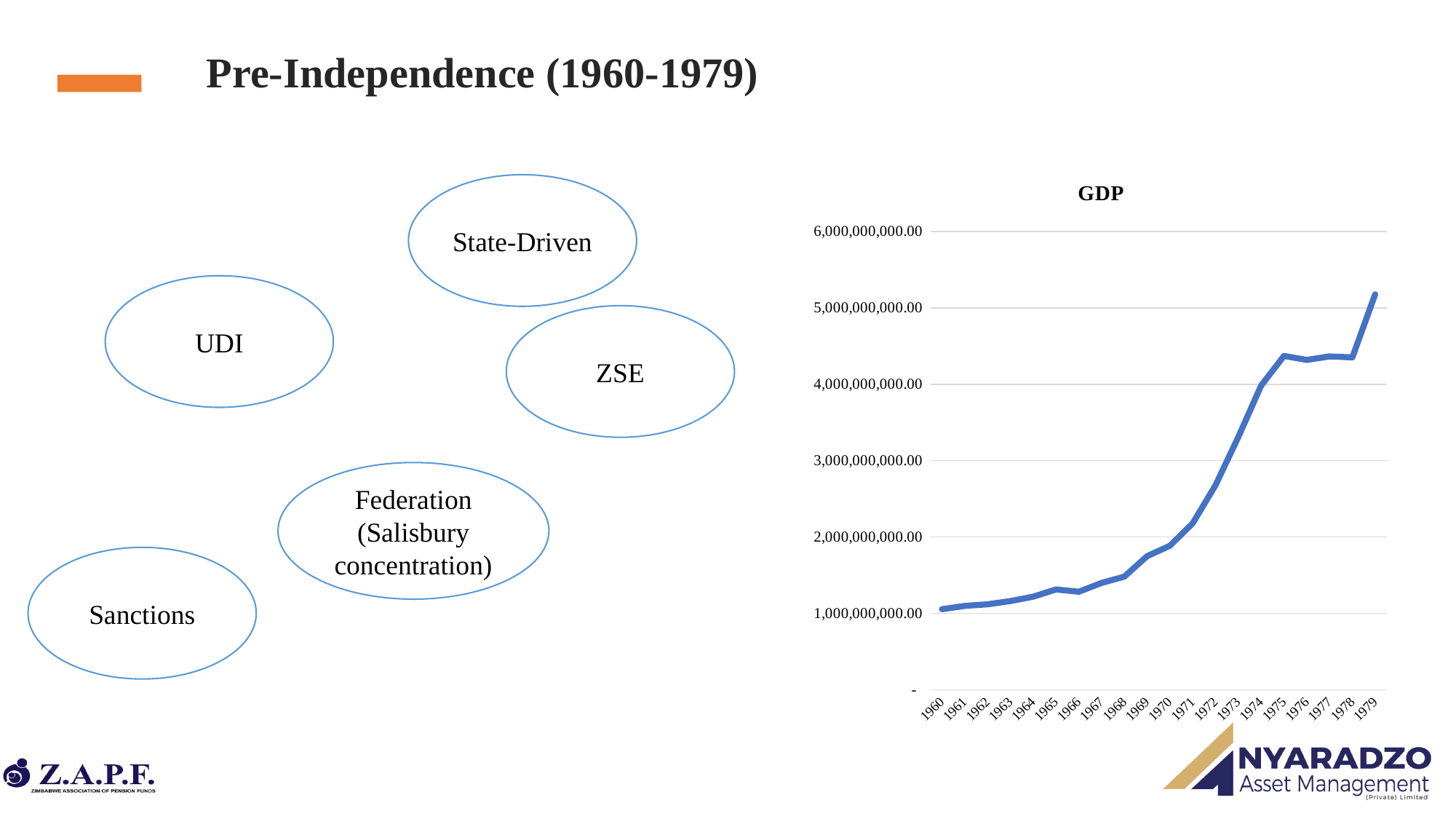
Is the GDP value for 1975 greater or less than 4,000,000,000.00? greater Which year has the highest GDP value in the chart? 1979 What is the title of the chart? GDP Is the GDP value for 1979 greater or less than 5,000,000,000.00? greater What kind of chart is shown on the slide? line chart Is the GDP value for 1972 greater or less than 3,000,000,000.00? less Which year has the lowest GDP value in the chart? 1960 Which year has the larger GDP value, 1972 or 1974? 1974 Which year has the larger GDP value, 1975 or 1979? 1979 How many years are plotted on the x axis of the GDP chart? 20 Does GDP generally rise or fall from 1960 to 1979? rise